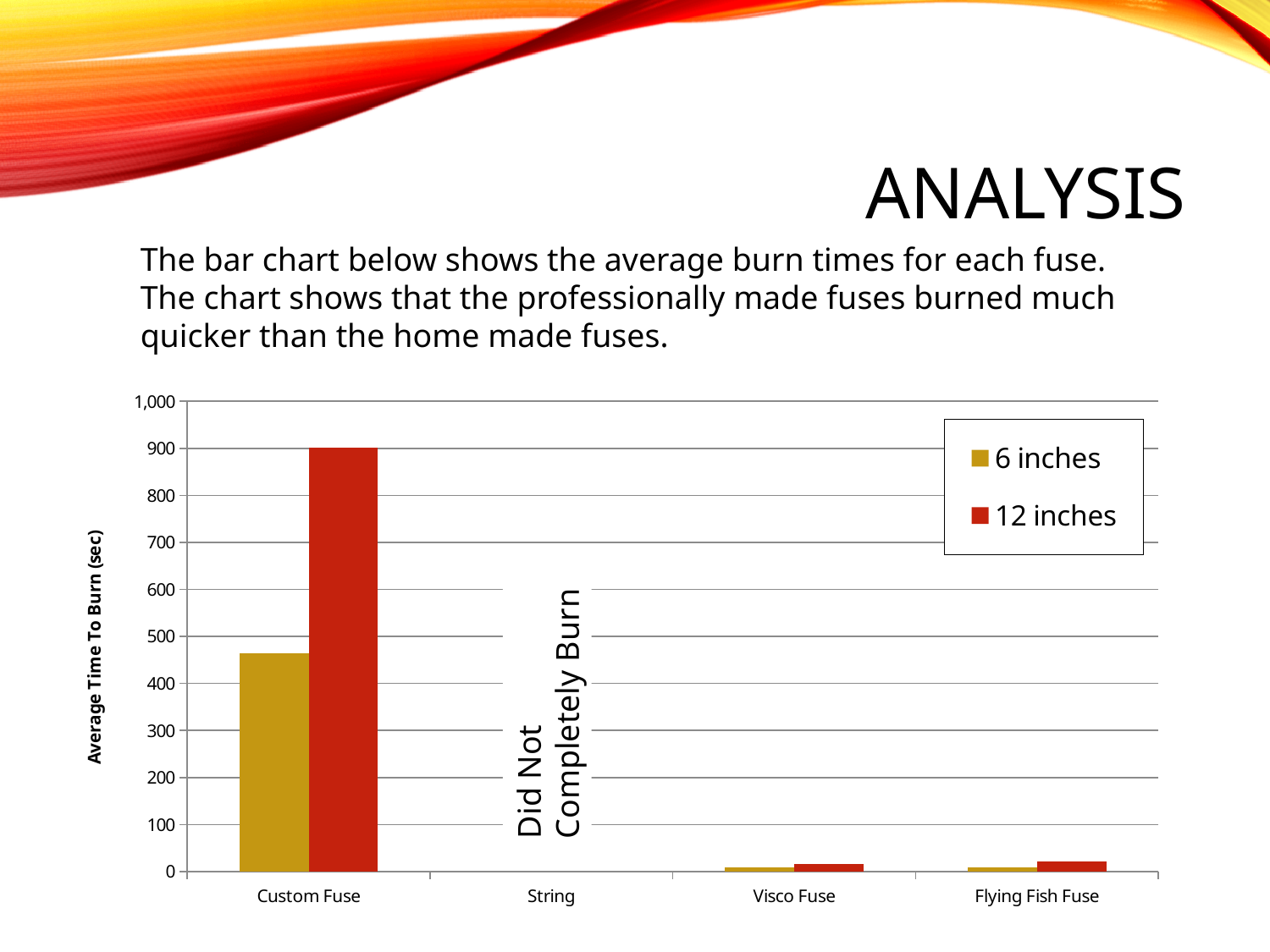
Is the 6 inches value for Custom Fuse greater or less than 400? greater Which fuse category has the highest average time to burn for 12 inches? Custom Fuse What does the chart say about the String category instead of showing bars? Did Not Completely Burn What are the two series named in the chart legend? 6 inches and 12 inches Which fuse category has the highest average time to burn for 6 inches? Custom Fuse What kind of chart is shown on the slide? bar chart How many fuse categories are shown on the x axis of the chart? 4 What is the label of the vertical axis of the chart? Average Time To Burn (sec) Is the 12 inches value for Custom Fuse greater or less than 800? greater Is the 12 inches value for Visco Fuse greater or less than 100? less How many series does the chart legend list? 2 For Custom Fuse, which is larger: the 6 inches value or the 12 inches value? 12 inches